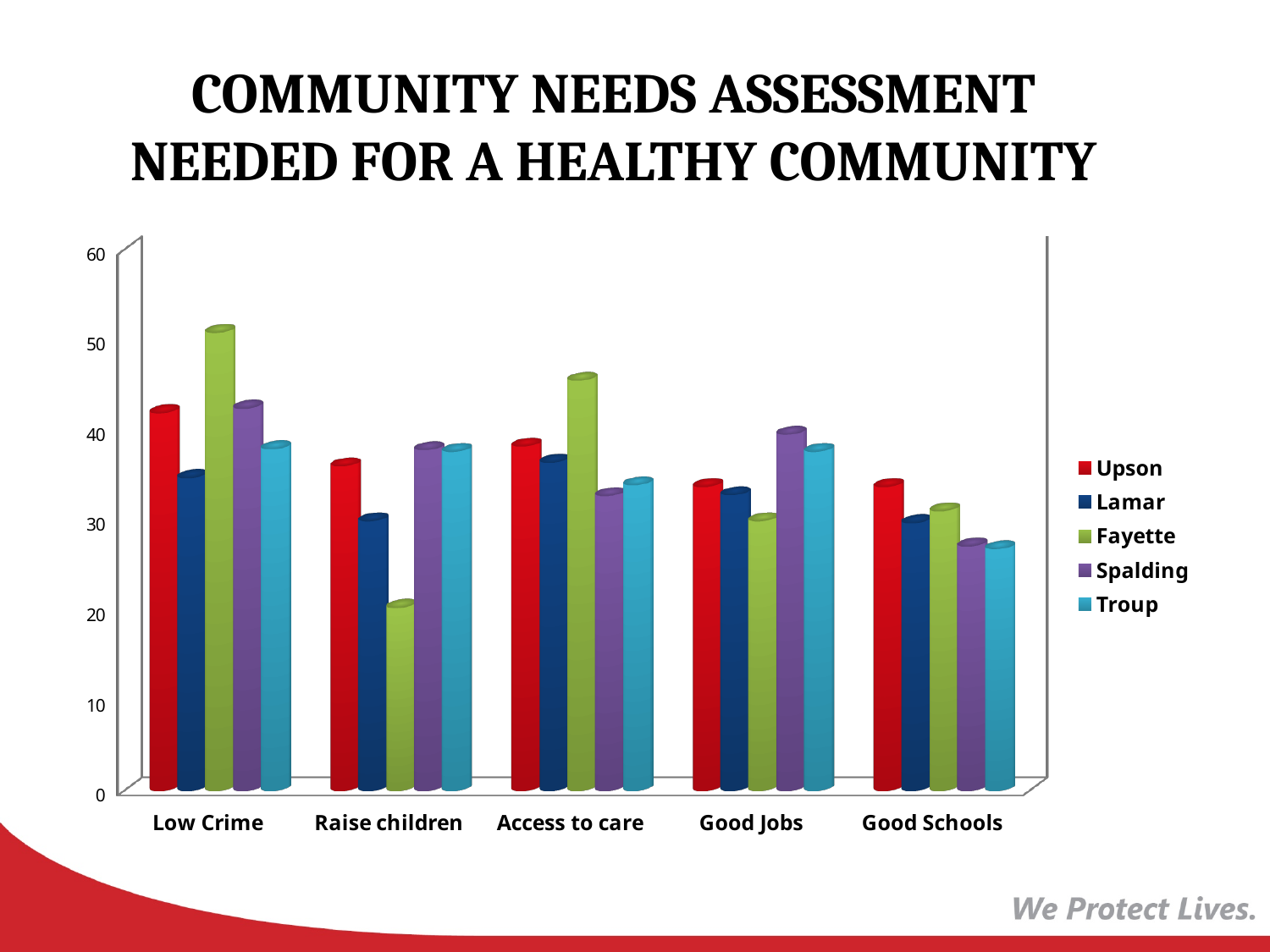
Is the Fayette value for Access to care greater or less than 40? greater For which category is the Fayette value highest? Low Crime For Raise children, which is larger: the Spalding value or the Fayette value? Spalding How many categories are shown along the x axis of the chart? 5 For which category is the Fayette value lowest? Raise children Is the Fayette value for Low Crime greater or less than 40? greater Which series has the highest value for Access to care? Fayette What kind of chart is shown on the slide? bar chart How many series does the chart's legend list? 5 Is the Fayette value for Raise children greater or less than 30? less For Low Crime, which is larger: the Fayette value or the Lamar value? Fayette